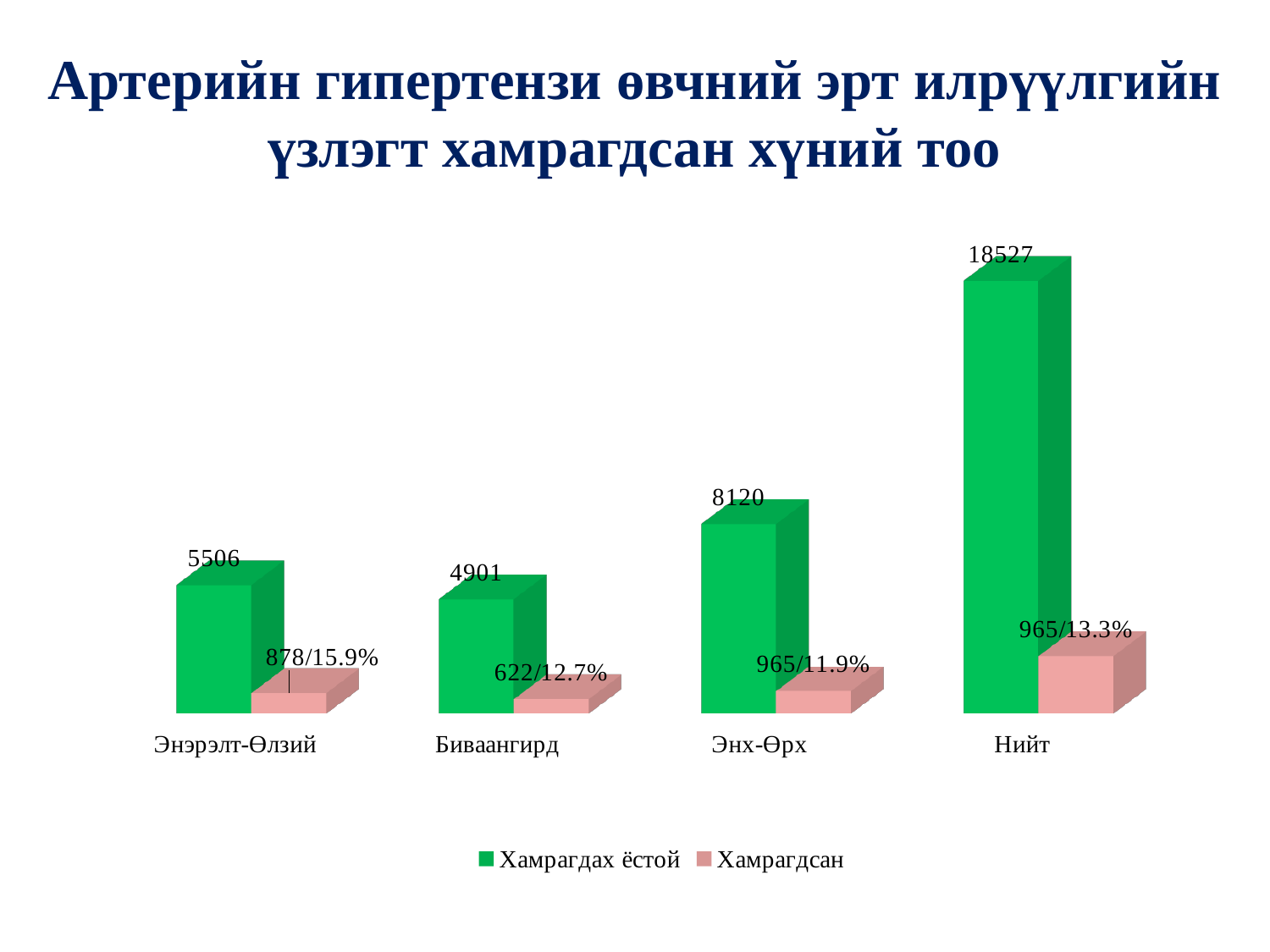
What is the value of the Хамрагдах ёстой series for Биваангирд? 4901 What is the difference between the Хамрагдах ёстой values for Энх-Өрх and Энэрэлт-Өлзий? 2614 Which is larger, the Хамрагдах ёстой value for Энэрэлт-Өлзий or for Биваангирд? Энэрэлт-Өлзий Which category has the lowest Хамрагдах ёстой value? Биваангирд How many series does the legend list? 2 What data label is shown on the Хамрагдсан bar for Биваангирд? 622/12.7% What is the value of the Хамрагдах ёстой series for Энх-Өрх? 8120 Which category has the highest Хамрагдах ёстой value? Нийт What data label is shown on the Хамрагдсан bar for Энэрэлт-Өлзий? 878/15.9% How many categories are shown on the x axis? 4 What is the value of the Хамрагдах ёстой series for Нийт? 18527 What kind of chart is shown on the slide? Bar chart